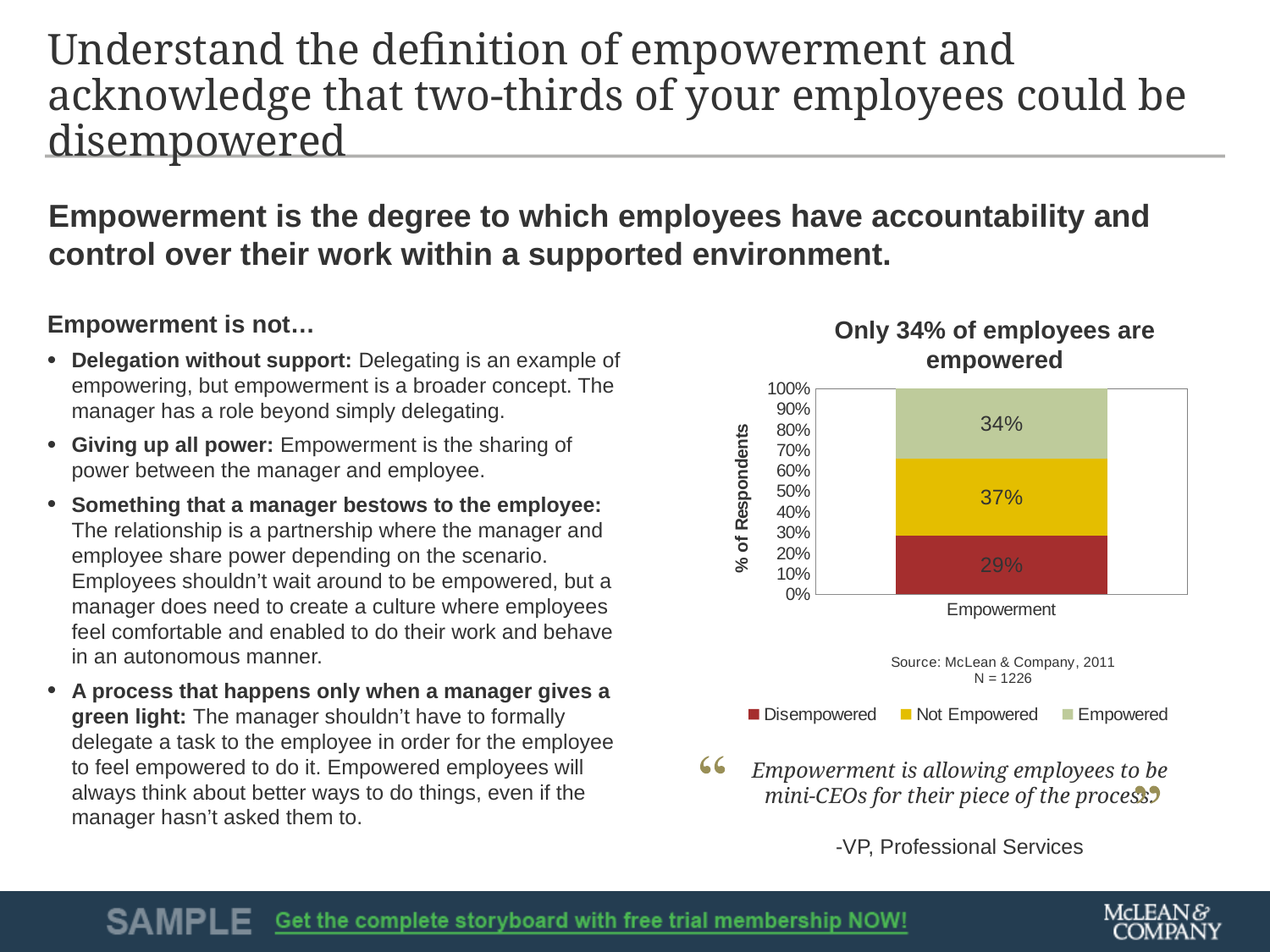
What is the label on the vertical axis of the chart? % of Respondents What kind of chart is shown on the slide? Stacked bar chart What percentage of respondents are Not Empowered? 37% Which is larger, the Empowered share or the Disempowered share? Empowered What percentage of respondents are Disempowered? 29% What is the total of the stacked bar for Empowerment? 100% Which series has the smallest share of respondents? Disempowered What is the difference between the Not Empowered and Disempowered percentages? 8% What percentage of respondents are Empowered? 34% How many series does the legend list? 3 Which series has the largest share of respondents? Not Empowered What is the title of the chart? Only 34% of employees are empowered